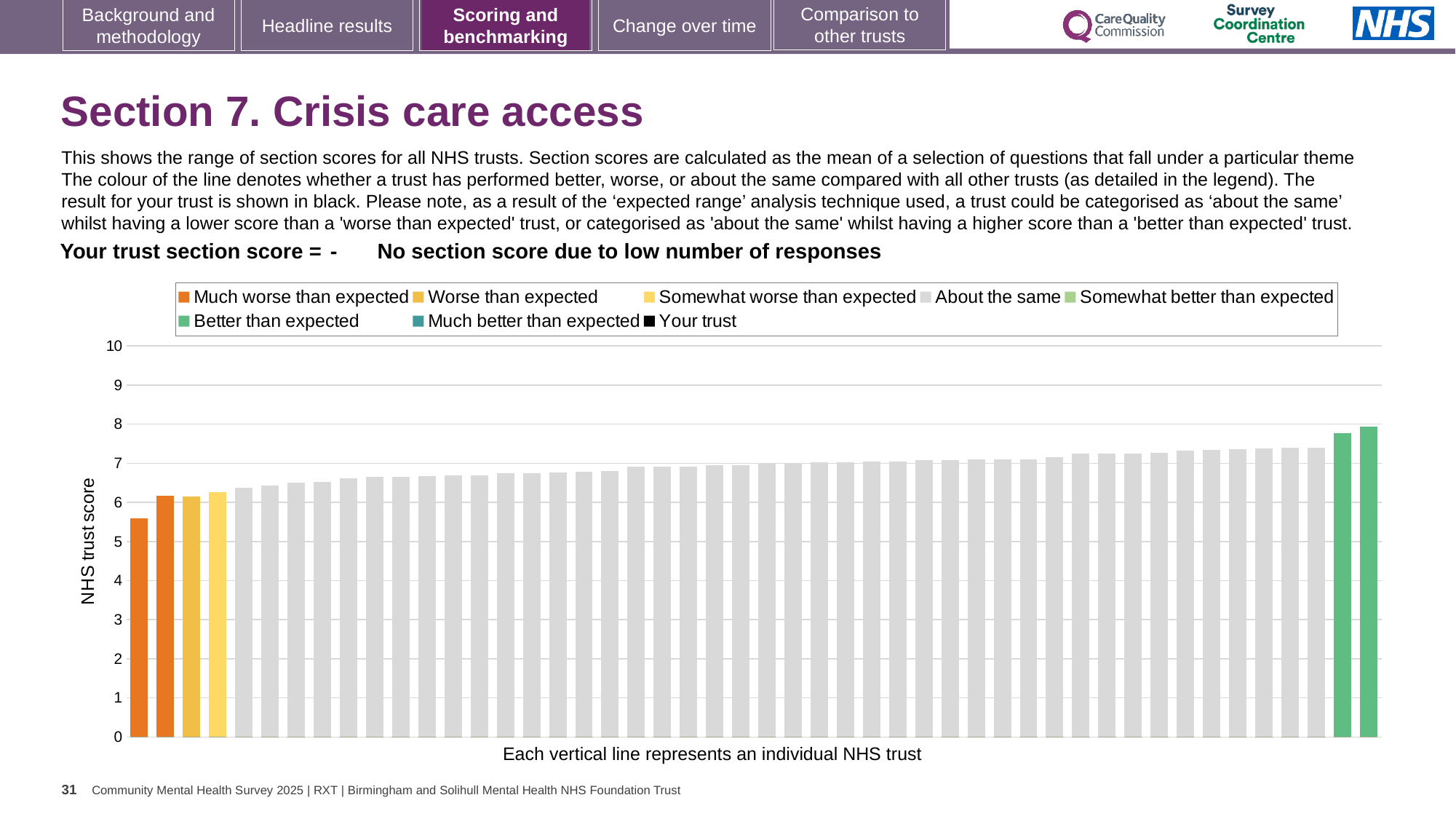
Is the value of the leftmost bar greater or less than 6? less Which bar is the highest in the chart, the leftmost or the rightmost? rightmost Is the value of the leftmost bar greater or less than 5? greater What is the highest tick value shown on the y axis? 10 Is the value of the rightmost bar greater or less than 7? greater Do the bar values rise or fall from left to right across the chart? rise Which bar is the lowest in the chart, the leftmost or the rightmost? leftmost What is the label of the y axis? NHS trust score How many entries does the chart legend list? 8 What kind of chart is shown on the slide? bar chart Which is larger, the value of the leftmost bar or the value of the rightmost bar? rightmost bar